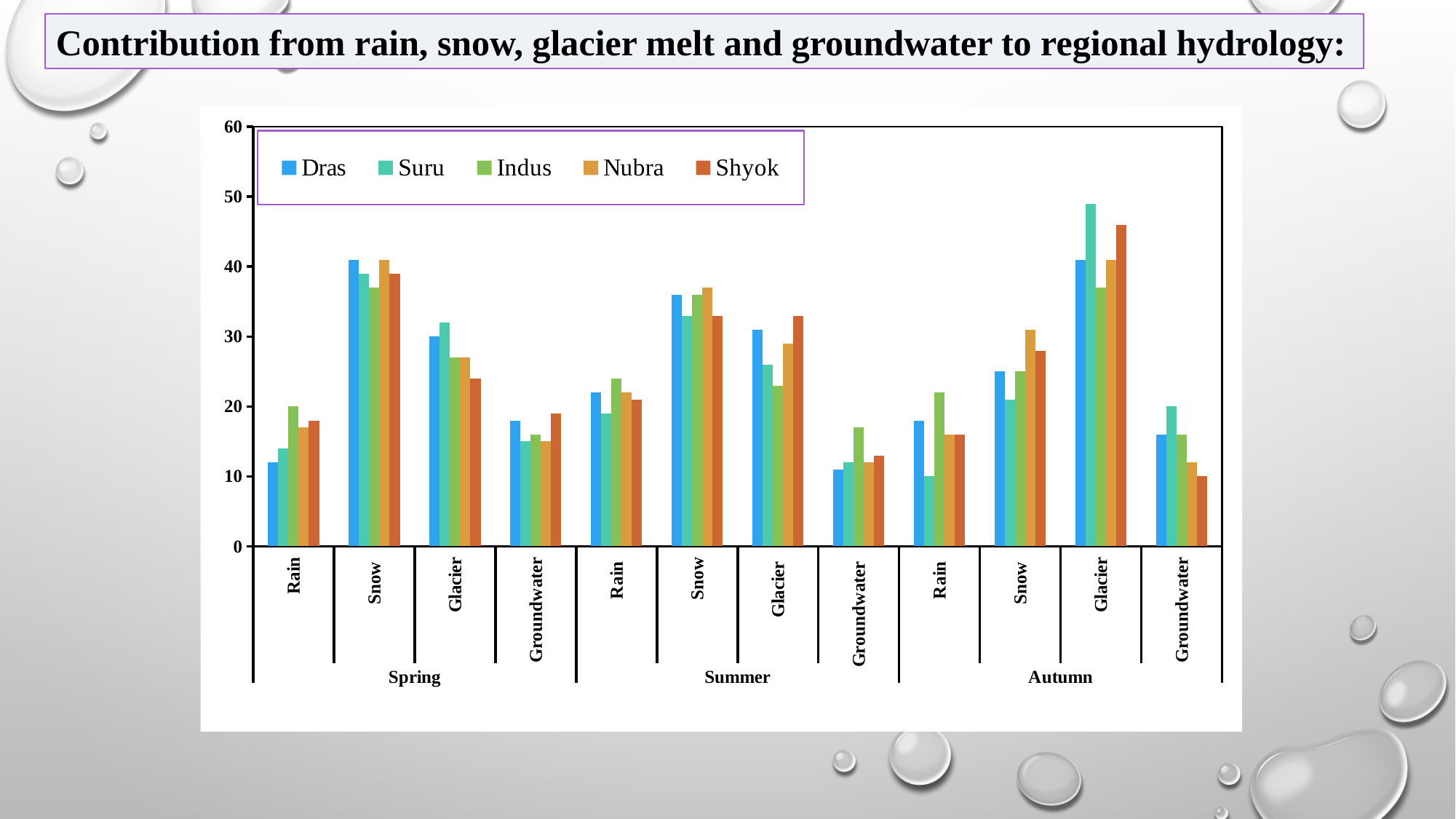
For Rain in Autumn, which is larger: Indus or Suru? Indus How many seasons are shown along the x axis? 3 Is the value for Dras for Groundwater in Summer greater or less than 20? less Which colour represents Dras in the legend? blue Is the value for Shyok for Snow in Spring greater or less than 30? greater Is the value for Suru for Glacier in Autumn greater or less than 40? greater For Groundwater in Summer, which series has the highest bar? Indus For Rain in Autumn, which series has the lowest bar? Suru For Glacier in Autumn, which series has the highest bar? Suru How many series does the legend list? 5 What kind of chart is shown on the slide? bar chart How many category groups of bars are plotted along the x axis in total? 12